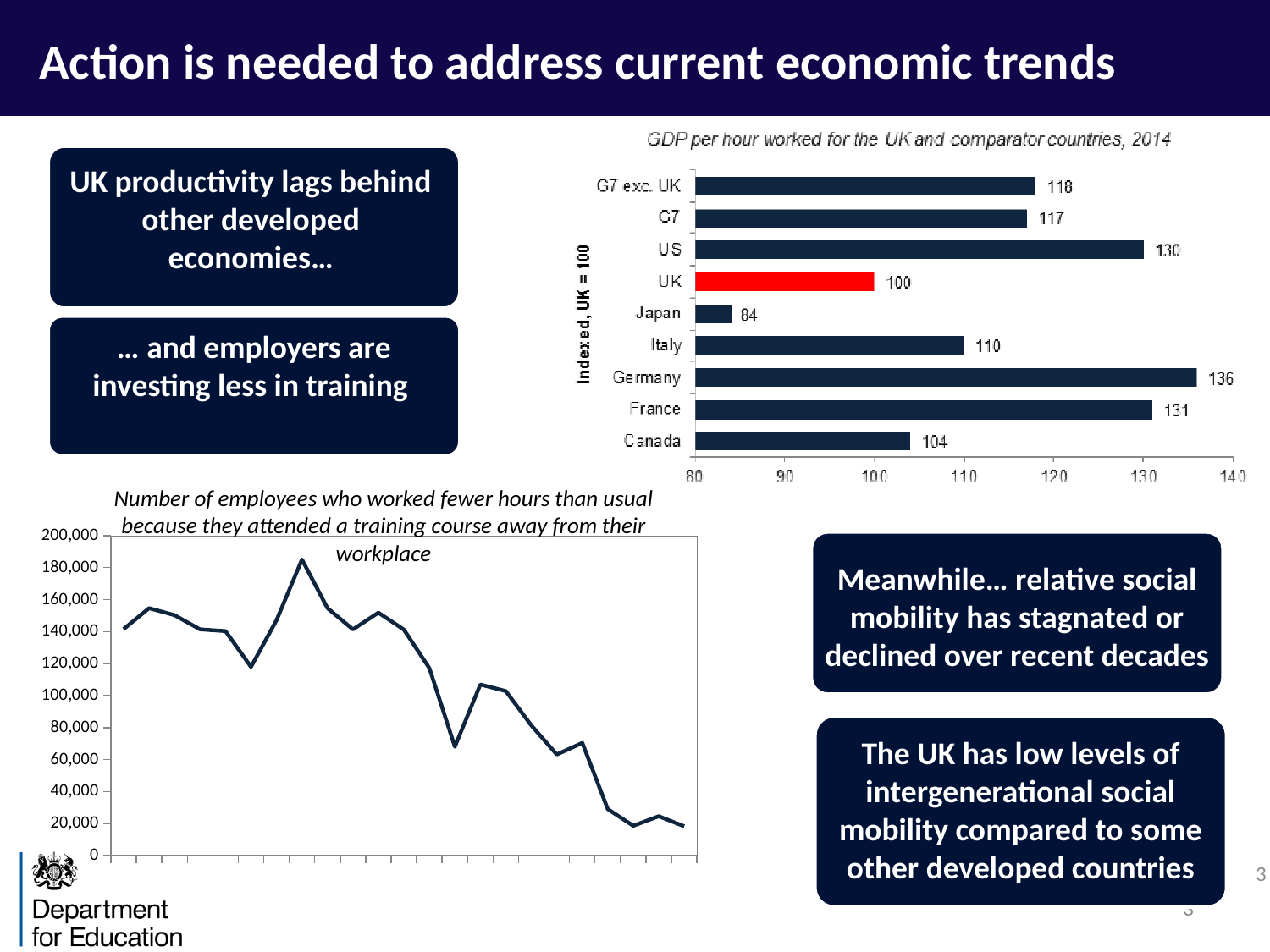
In the 'Number of employees who worked fewer hours than usual' chart, do the values generally rise or fall along the x axis? Fall In the 'GDP per hour worked' chart, which country has the highest value? Germany In the 'GDP per hour worked' chart, what is the value for Germany? 136 In the 'GDP per hour worked' chart, which is larger, the value for Italy or the value for Canada? Italy In the 'GDP per hour worked' chart, how many countries or groups are shown? 9 In the 'GDP per hour worked' chart, which bar is coloured red? UK In the 'GDP per hour worked' chart, what is the value for Japan? 84 In the 'GDP per hour worked' chart, which country has the lowest value? Japan What kind of chart is the 'Number of employees who worked fewer hours than usual' chart? Line chart In the 'GDP per hour worked' chart, what is the value for France? 131 What kind of chart is the 'GDP per hour worked' chart? Bar chart In the 'GDP per hour worked' chart, what is the difference between the US and the UK values? 30